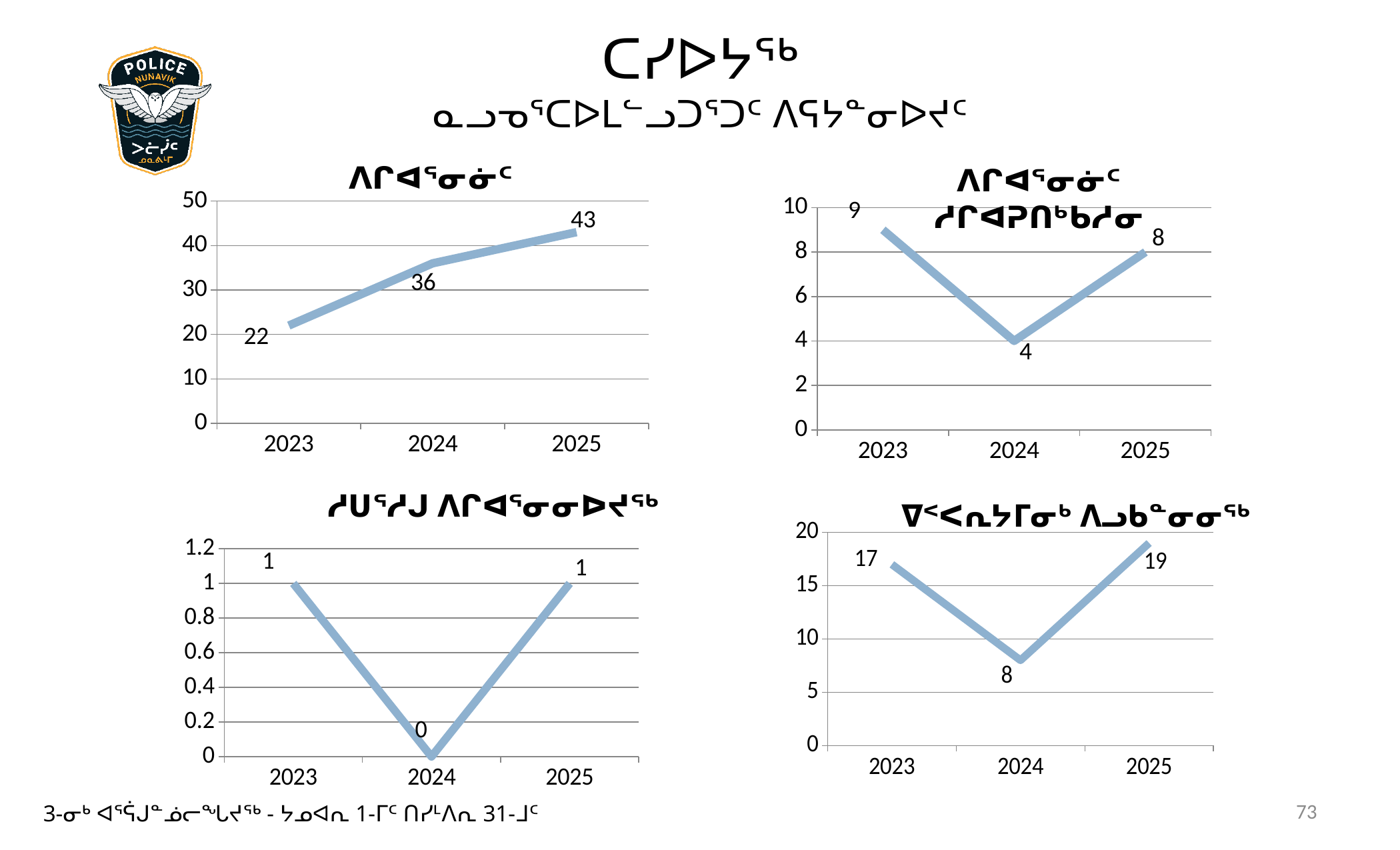
In the bottom-left chart, what is the value for 2024? 0 In the top-right chart, which year has the lowest value? 2024 In the top-left chart, do the values rise or fall from 2023 to 2025? rise In the bottom-right chart, what is the difference between the 2023 and 2024 values? 9 In the top-right chart, which is larger, the value for 2023 or the value for 2025? 2023 In the top-right chart, what is the value for 2024? 4 How many years are plotted in the bottom-left chart? 3 What kind of chart is the bottom-right chart? line chart In the top-left chart, what is the difference between the 2025 and 2023 values? 21 In the top-left chart, what is the value for 2024? 36 In the bottom-right chart, what is the value for 2025? 19 In the top-left chart, which year has the highest value? 2025